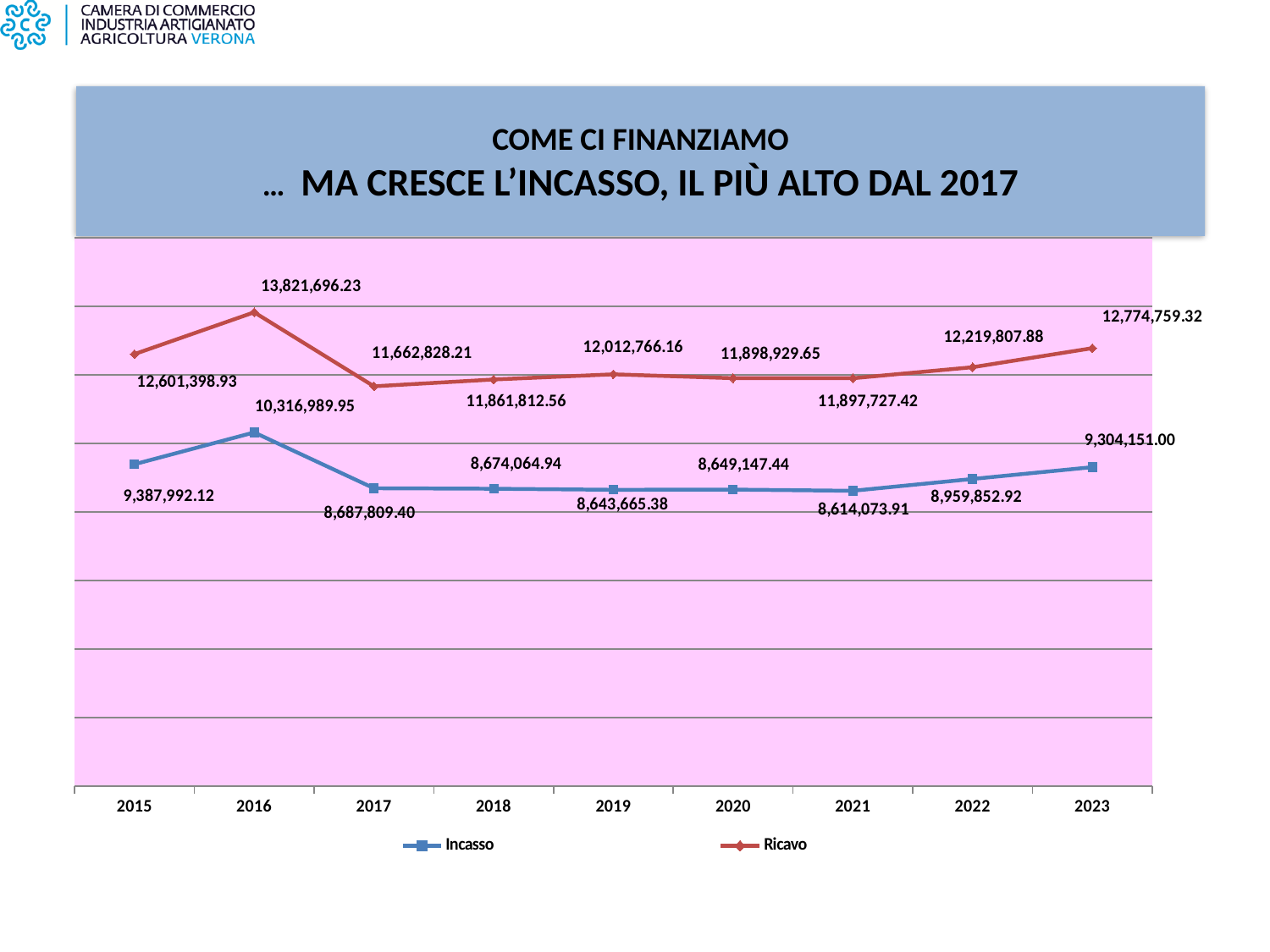
What kind of chart is shown on the slide? Line chart In which year is the Ricavo value lowest? 2017 What is the Ricavo value for 2016? 13,821,696.23 What is the Incasso value for 2018? 8,674,064.94 In which year is the Incasso value highest? 2016 What is the Incasso value for 2023? 9,304,151.00 How many series does the legend list? 2 By how much did the Incasso value increase from 2022 to 2023? 344,298.08 What is the Ricavo value for 2021? 11,897,727.42 Which is larger, the Incasso value in 2015 or in 2023? 2015 How many years are shown on the x axis? 9 What is the difference between the Ricavo and Incasso values in 2023? 3,470,608.32